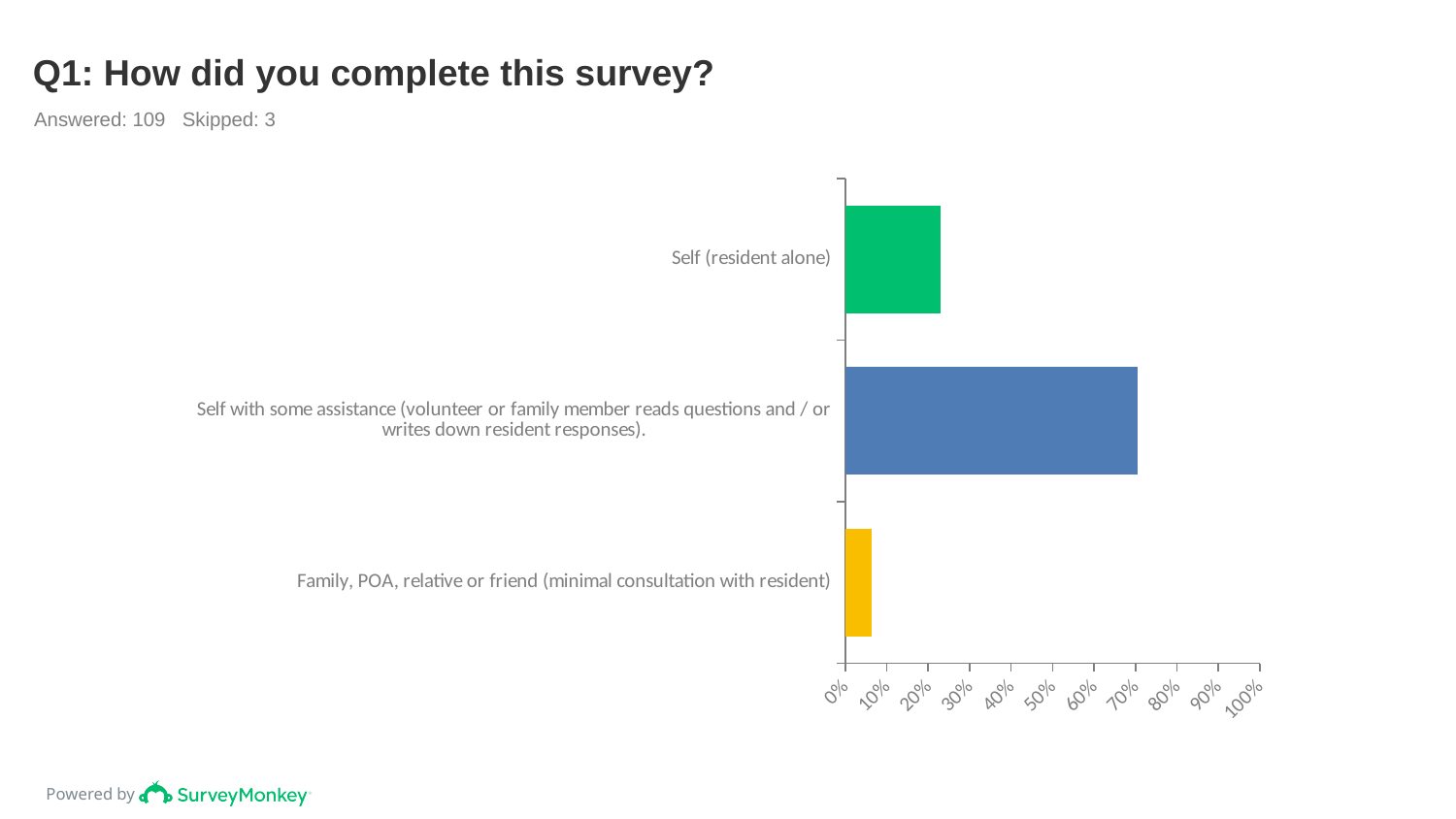
Is the value for Self (resident alone) greater or less than 30%? less Is the value for Family, POA, relative or friend (minimal consultation with resident) greater or less than 10%? less How many respondents answered this question according to the slide? 109 Which is larger: the value for Self (resident alone) or the value for Family, POA, relative or friend (minimal consultation with resident)? Self (resident alone) Which category has the highest value? Self with some assistance (volunteer or family member reads questions and / or writes down resident responses). What is the title of the chart? Q1: How did you complete this survey? What kind of chart is shown on the slide? Bar chart Which category has the lowest value? Family, POA, relative or friend (minimal consultation with resident) Is the value for Self (resident alone) greater or less than 10%? greater How many categories are plotted in the chart? 3